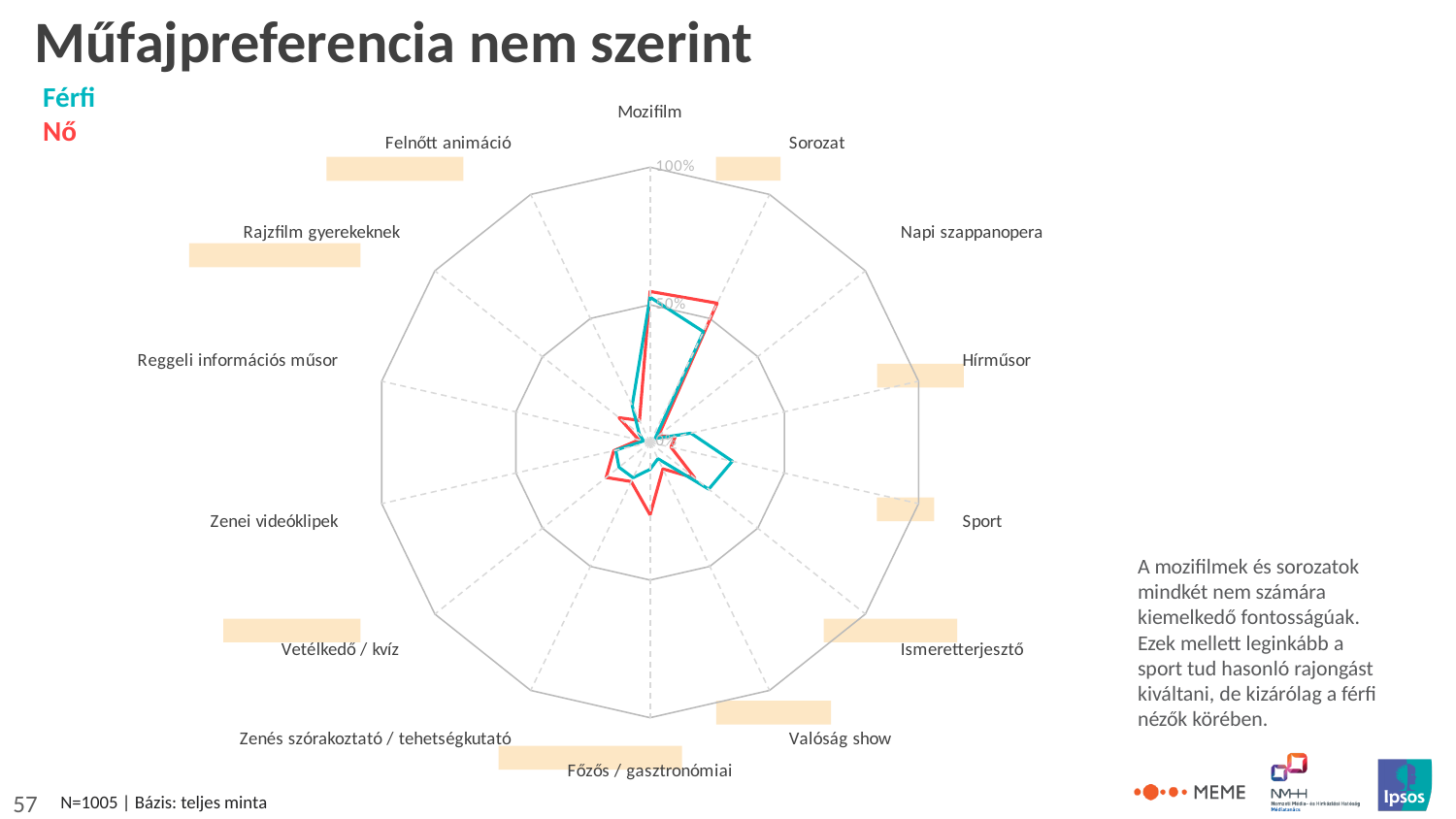
How many genre categories are plotted on the radar chart? 14 Which series has the higher value for Sport, Férfi or Nő? Férfi Is the value for Sport in the Férfi series greater or less than 50%? less How many series does the legend list? 2 Which series has the higher value for Főzős / gasztronómiai, Férfi or Nő? Nő Is the value for Valóság show in the Férfi series greater or less than 50%? less Is the value for Mozifilm in the Nő series greater or less than 100%? less What colour is used for the Nő series? red What is the title of the chart slide? Műfajpreferencia nem szerint What kind of chart is shown on the slide? radar chart